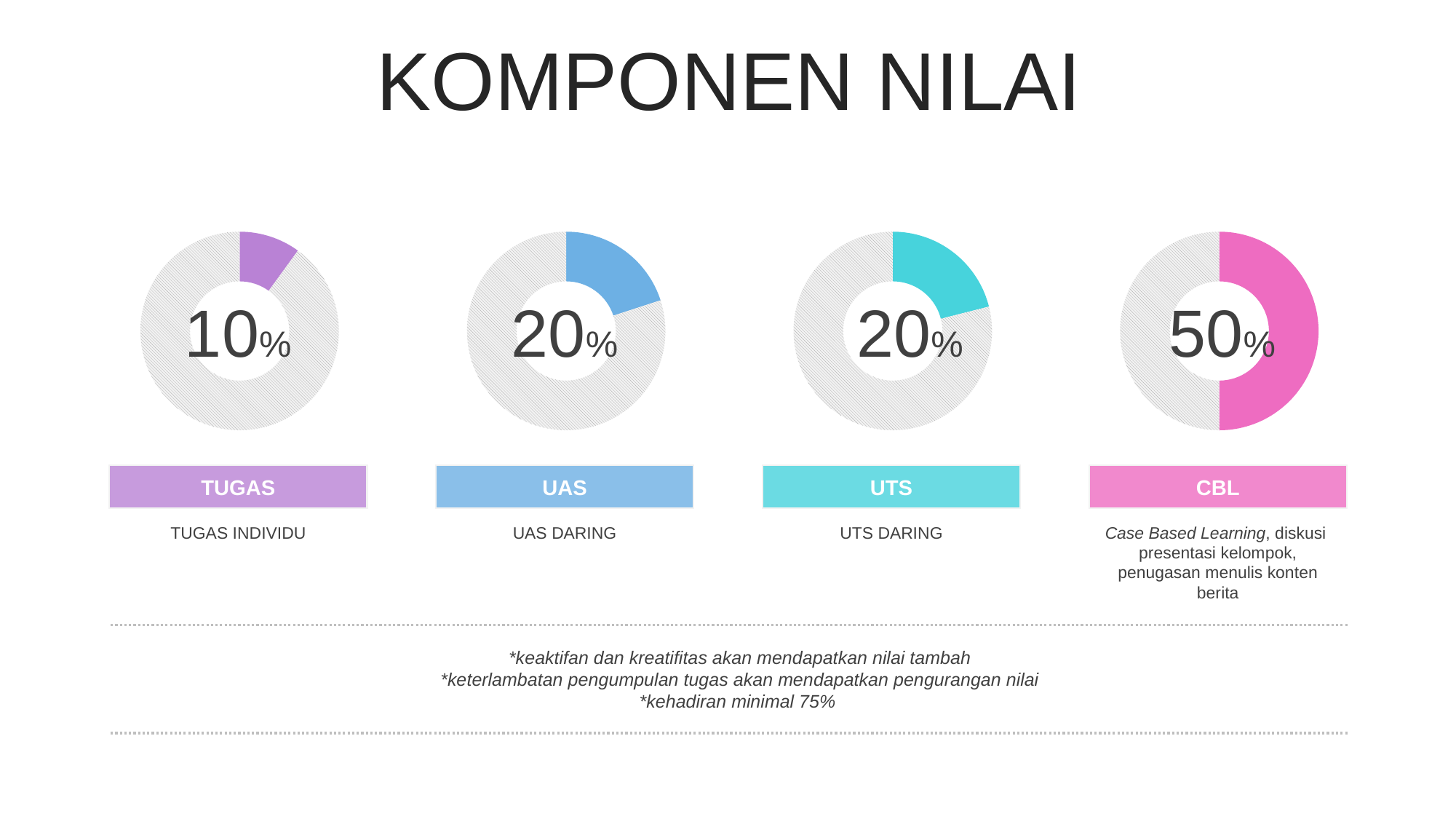
What percentage is shown in the CBL donut chart? 50% What kind of chart is used to show each component's percentage? Donut chart What is the difference between the CBL percentage and the TUGAS percentage? 40% What percentage is shown in the TUGAS donut chart? 10% Which is larger, the UAS percentage or the TUGAS percentage? UAS How many donut charts are on the slide? 4 Which component has the highest percentage? CBL What is the total of the four component percentages? 100% Which component has the lowest percentage? TUGAS What percentage is shown in the UAS donut chart? 20% What percentage is shown in the UTS donut chart? 20% What colour is the filled segment of the CBL donut chart? Pink